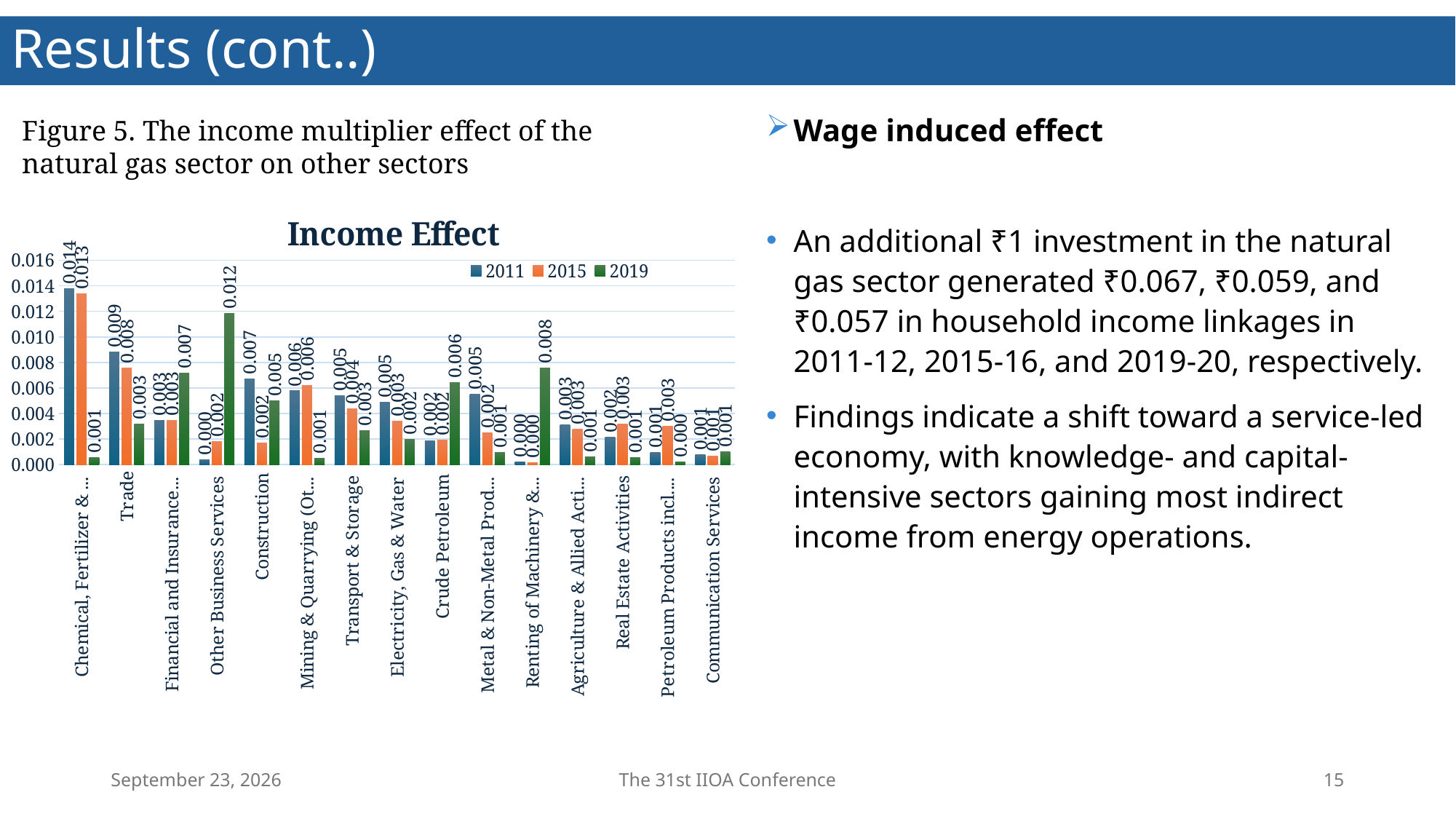
How many sector categories are shown on the x axis of the Income Effect chart? 15 Which sector has the highest 2011 value in the Income Effect chart? Chemical, Fertilizer &... What is the difference between the 2011 and 2019 values for Chemical, Fertilizer in the Income Effect chart? 0.013 Which sector has the highest 2019 value in the Income Effect chart? Other Business Services What is the 2019 value for Renting of Machinery in the Income Effect chart? 0.008 What is the title of the chart on the slide? Income Effect How many series does the legend of the Income Effect chart list? 3 Which is larger in the Income Effect chart: the 2019 value for Other Business Services or the 2019 value for Trade? Other Business Services Is the 2011 value for Chemical, Fertilizer in the Income Effect chart greater or less than 0.010? greater What kind of chart is shown on the slide? bar chart What is the 2011 value for Trade in the Income Effect chart? 0.009 What is the 2019 value for Other Business Services in the Income Effect chart? 0.012